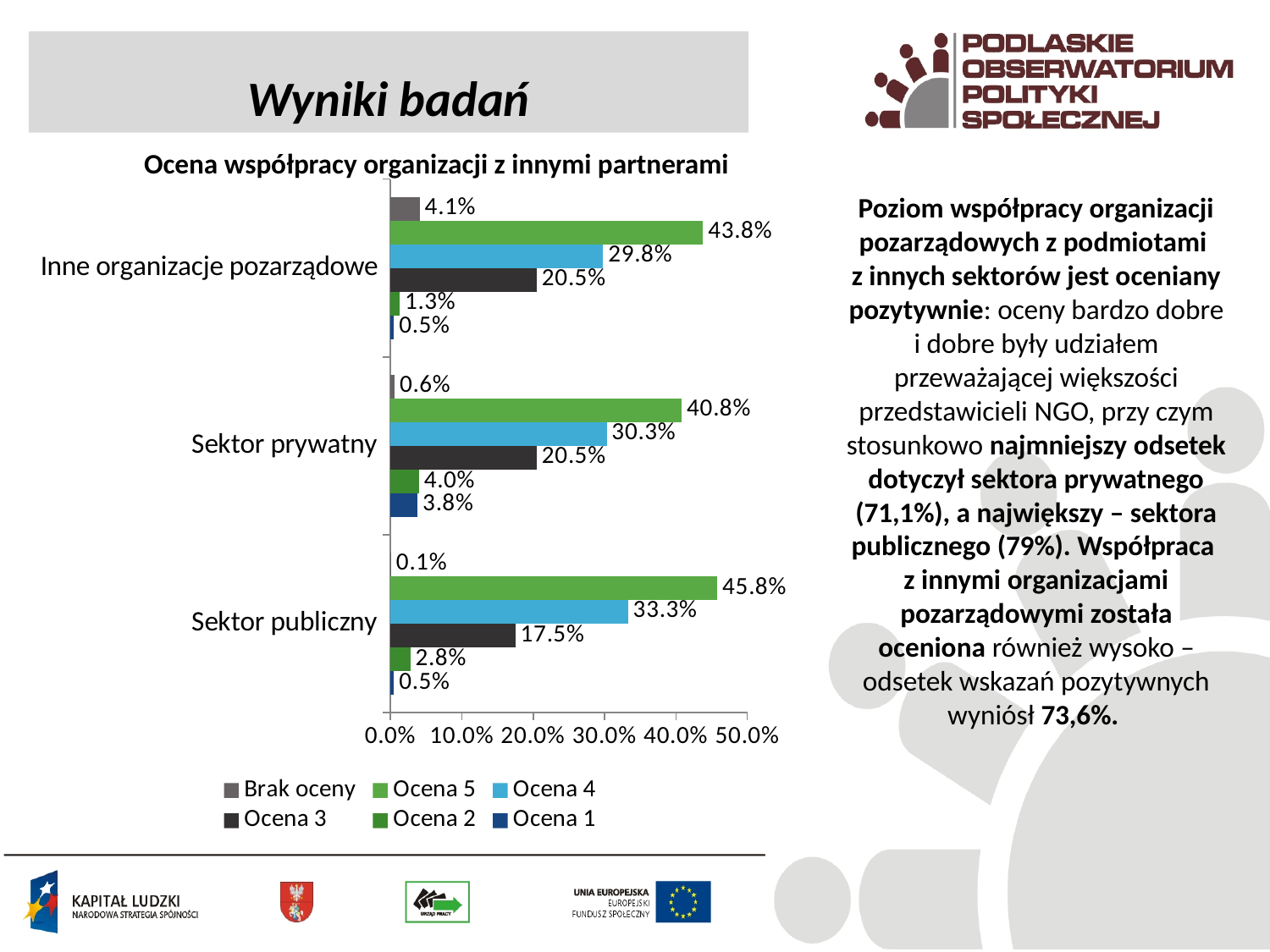
How many series does the chart legend list? 6 What is the difference between the Ocena 5 values for Sektor publiczny and Sektor prywatny? 5.0% What is the title of the chart? Ocena współpracy organizacji z innymi partnerami How many categories are shown on the chart? 3 Which category has the lowest value for Ocena 3? Sektor publiczny What is the value of Brak oceny for Inne organizacje pozarządowe? 4.1% What is the value of Ocena 5 for Sektor publiczny? 45.8% Which category has the highest value for Ocena 5? Sektor publiczny What kind of chart is shown on the slide? bar chart What is the value of Ocena 4 for Sektor prywatny? 30.3% Is the value of Ocena 4 for Sektor publiczny greater or less than 30.0%? greater Which is larger: Ocena 1 for Sektor prywatny or Ocena 1 for Sektor publiczny? Sektor prywatny